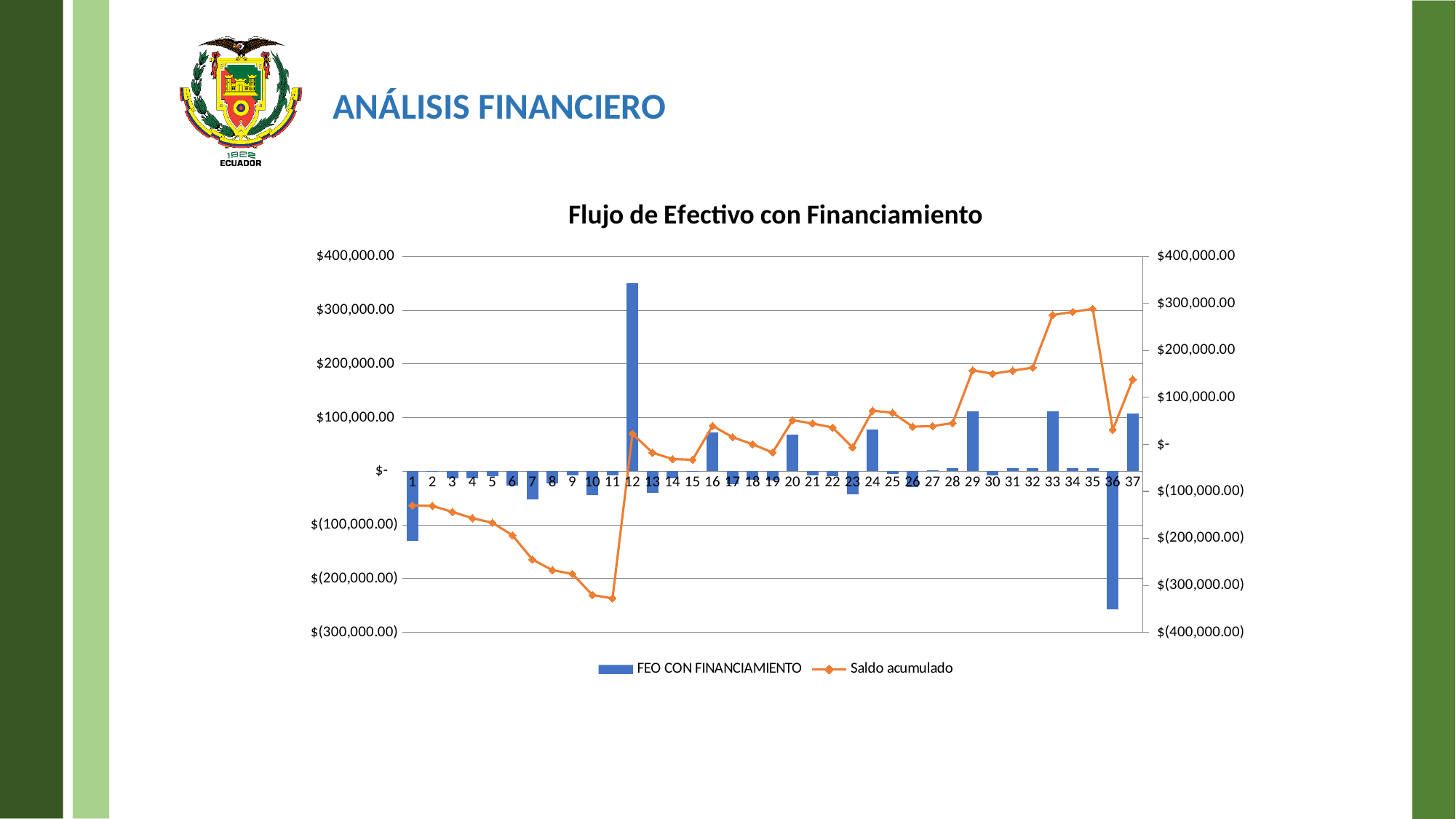
What kind of chart is this? Combined bar and line chart In which period is the FEO CON FINANCIAMIENTO bar the lowest? 36 What is the title of the chart? Flujo de Efectivo con Financiamiento Is the Saldo acumulado value for period 35 greater or less than $200,000.00 on the right axis? greater In which period is the FEO CON FINANCIAMIENTO bar the highest? 12 How many periods are shown on the x axis? 37 How many series does the legend list? 2 In which period does the Saldo acumulado line reach its lowest point? 11 Which is larger, the FEO CON FINANCIAMIENTO bar for period 12 or for period 29? Period 12 Is the FEO CON FINANCIAMIENTO value for period 12 greater or less than $300,000.00? greater Does the Saldo acumulado line rise or fall from period 1 to period 11? fall Is the FEO CON FINANCIAMIENTO value for period 36 greater or less than $(200,000.00)? less